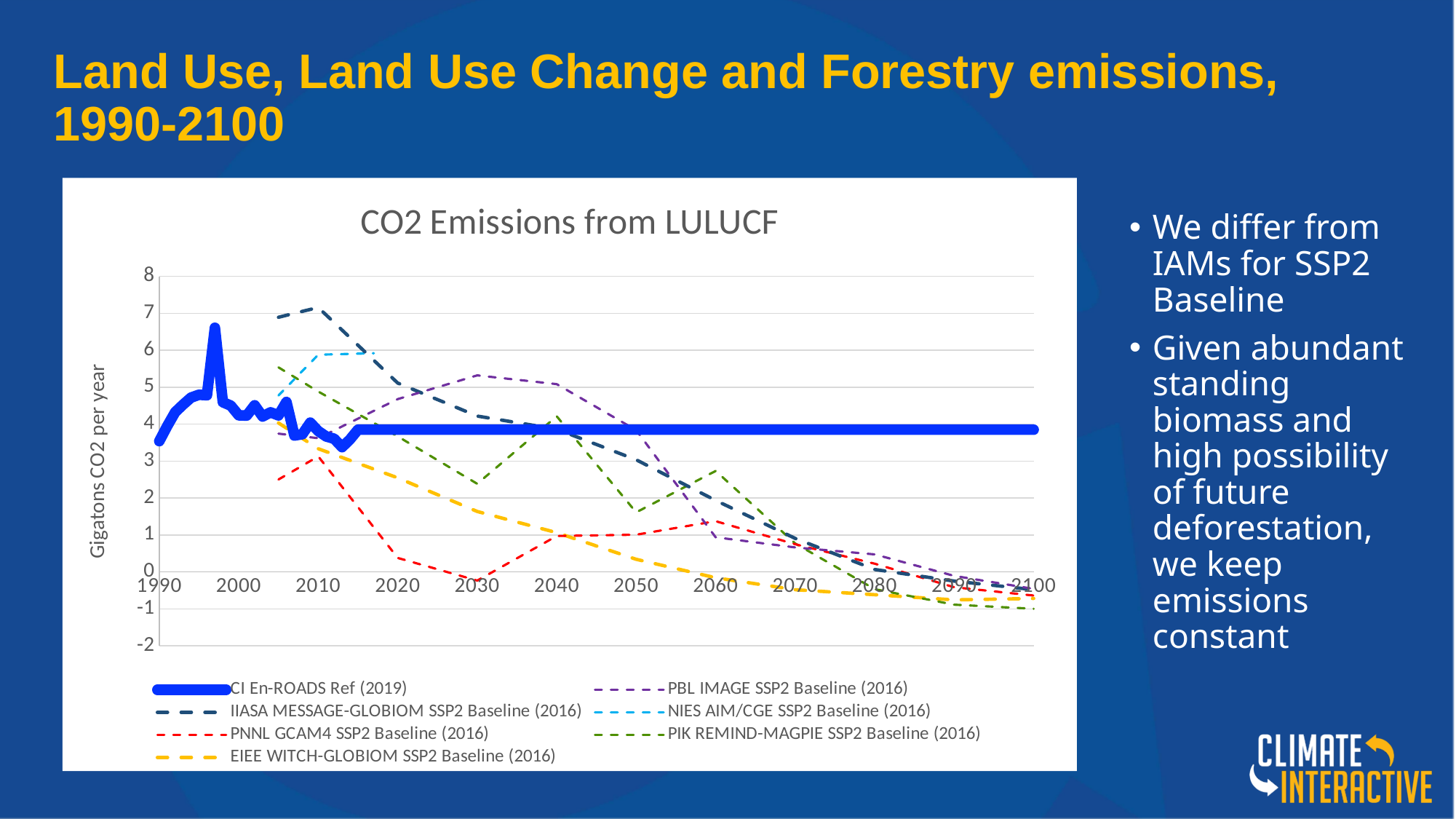
Is the value for CI En-ROADS Ref (2019) in 2100 greater or less than 3? greater What is the label on the vertical axis of the chart? Gigatons CO2 per year Do the values for EIEE WITCH-GLOBIOM SSP2 Baseline (2016) rise or fall from 2005 to 2100? fall Is the value for PNNL GCAM4 SSP2 Baseline (2016) in 2030 greater or less than 1? less Is the value for PBL IMAGE SSP2 Baseline (2016) in 2030 greater or less than 5? greater In 2010, which is larger: IIASA MESSAGE-GLOBIOM SSP2 Baseline (2016) or PNNL GCAM4 SSP2 Baseline (2016)? IIASA MESSAGE-GLOBIOM SSP2 Baseline (2016) What kind of chart is shown on the slide? line chart How many series does the chart legend list? 7 Which series has the highest value around 2010? IIASA MESSAGE-GLOBIOM SSP2 Baseline (2016) What is the title of the chart? CO2 Emissions from LULUCF